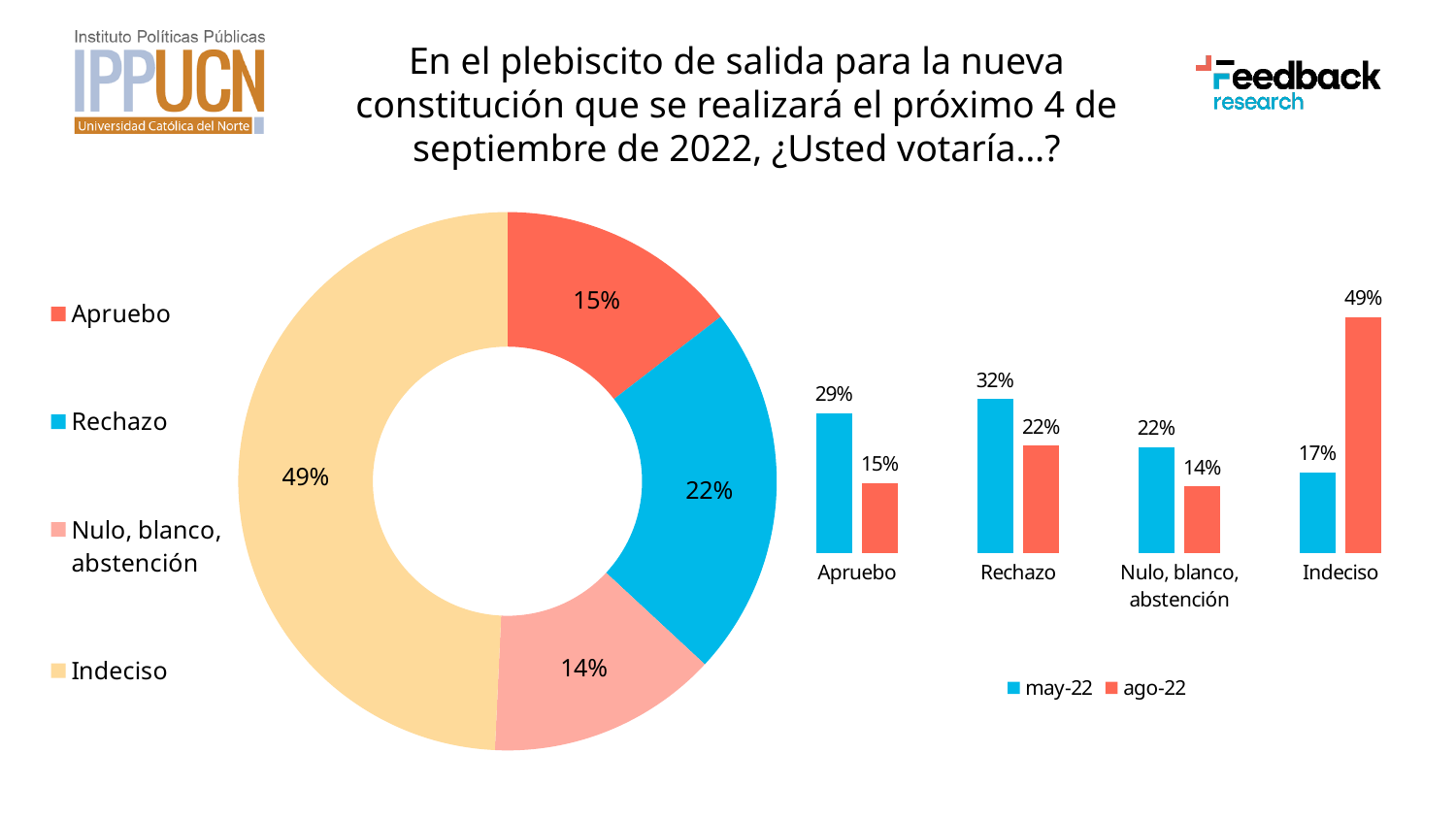
In the bar chart on the right, what is the may-22 value for Rechazo? 32% What kind of chart is the one on the left of the slide? Pie (donut) chart In the bar chart on the right, which category has the highest ago-22 value? Indeciso In the donut chart on the left, how many categories are shown? 4 In the bar chart on the right, which is larger for Indeciso: the may-22 value or the ago-22 value? ago-22 In the bar chart on the right, which category has the lowest may-22 value? Indeciso In the bar chart on the right, what is the difference between the may-22 and ago-22 values for Apruebo? 14% In the donut chart on the left, what share is shown for Indeciso? 49% In the bar chart on the right, what colour are the ago-22 bars? Red (orange-red) In the donut chart on the left, which category has the smallest slice? Nulo, blanco, abstención In the bar chart on the right, how many series does the legend list? 2 In the bar chart on the right, what is the ago-22 value for Nulo, blanco, abstención? 14%